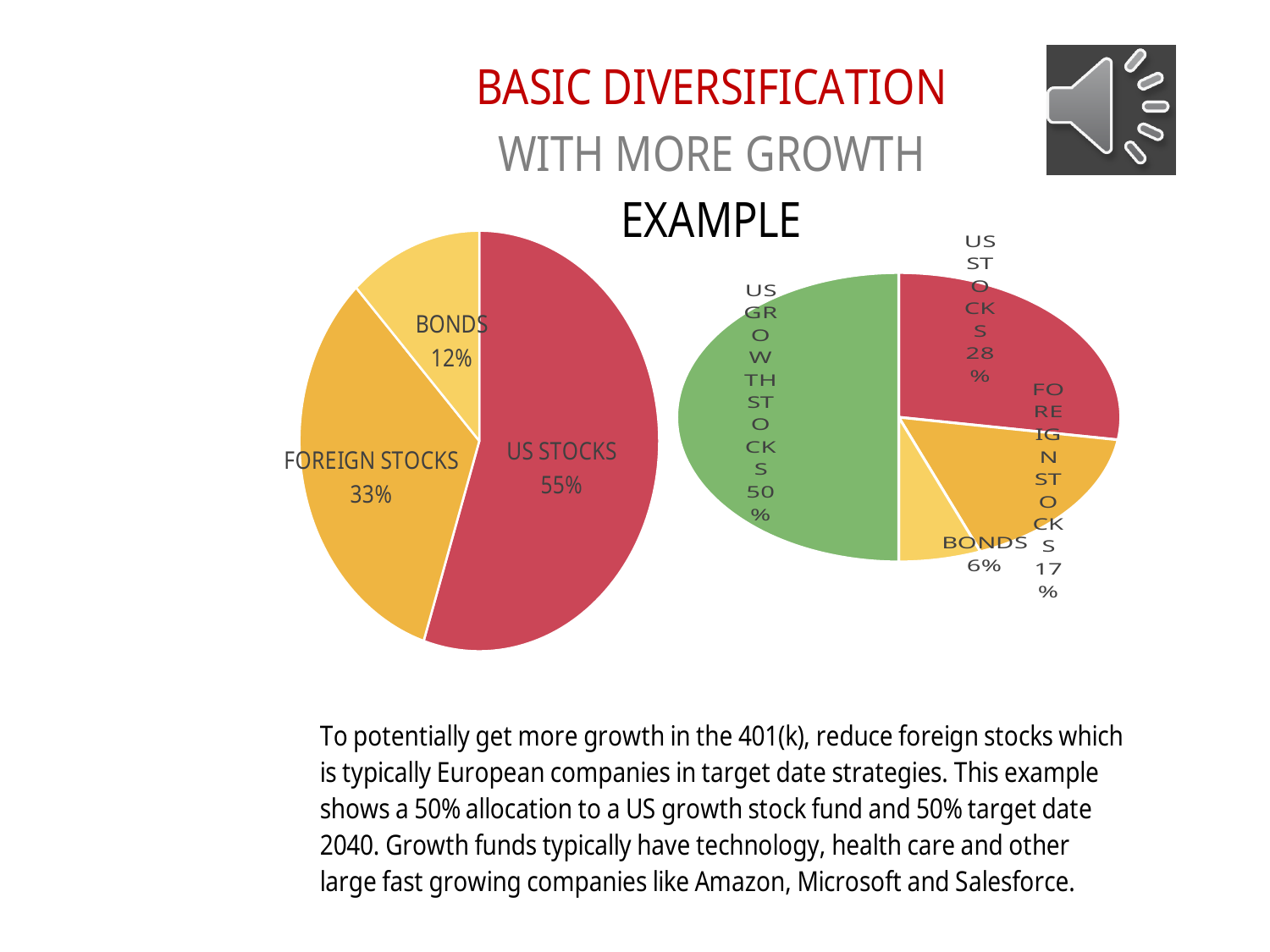
In the left pie chart, which category has the smallest slice? BONDS In the left pie chart, what share is labelled for BONDS? 12% How many slices does the left pie chart have? 3 What type of chart is shown on the right of the slide? Pie chart In the right pie chart, what share is labelled for FOREIGN STOCKS? 17% In the left pie chart, which category has the largest slice? US STOCKS In the left pie chart, what share is labelled for US STOCKS? 55% In the right pie chart, which category has the smallest slice? BONDS In the left pie chart, what is the difference between the US STOCKS share and the FOREIGN STOCKS share? 22% In the right pie chart, which is larger, US STOCKS or FOREIGN STOCKS? US STOCKS In the right pie chart, what share is labelled for US GROWTH STOCKS? 50% In the left pie chart, what share is labelled for FOREIGN STOCKS? 33%